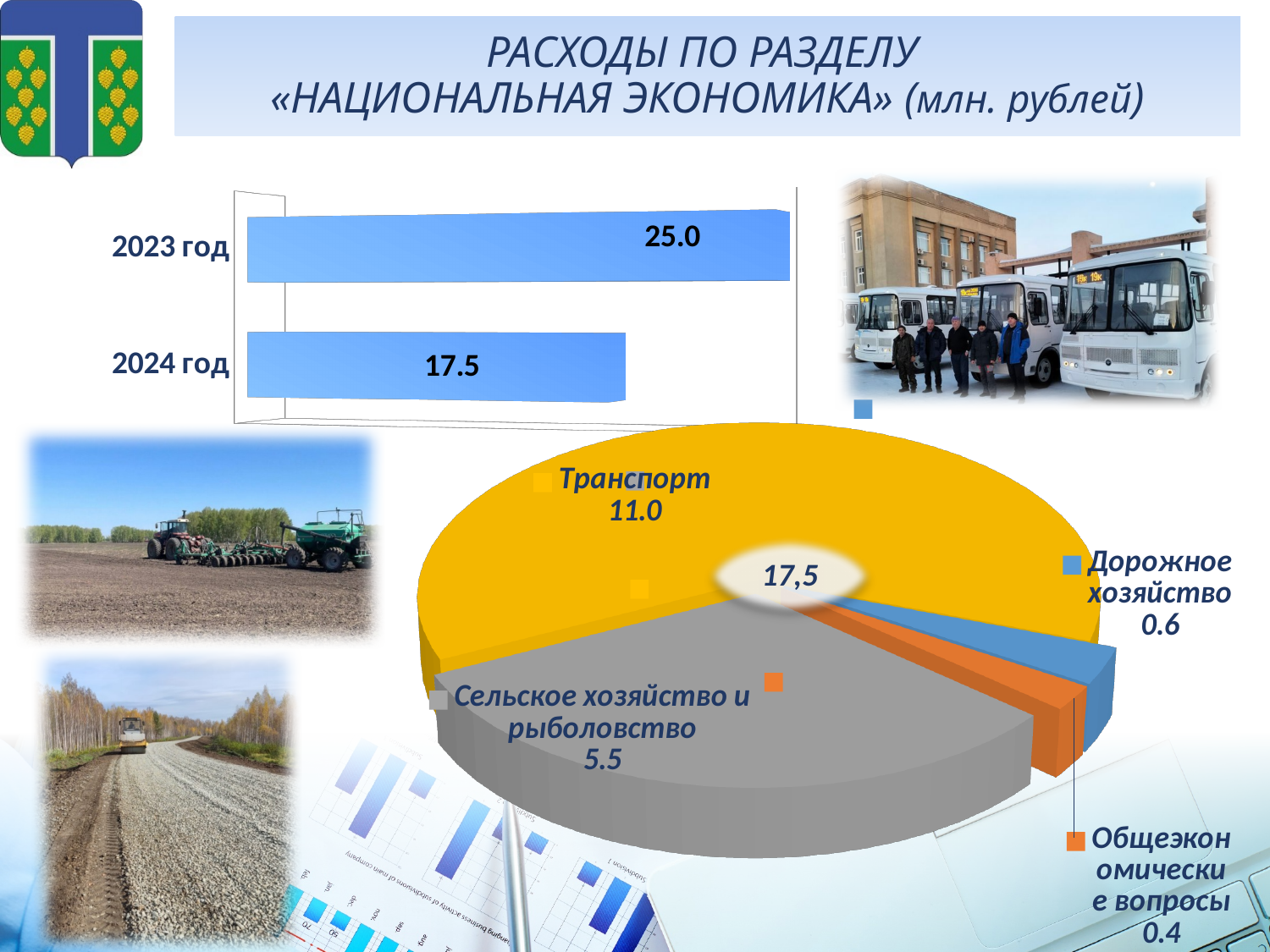
On the bar chart, what is the difference between the 2023 год and 2024 год values? 7.5 On the bar chart, what is the value for 2023 год? 25.0 On the bar chart, what is the value for 2024 год? 17.5 On the pie chart, what is the value for Дорожное хозяйство? 0.6 On the pie chart, how many slices are there? 4 On the pie chart, what is the difference between Транспорт and Сельское хозяйство и рыболовство? 5.5 On the pie chart, what is the value for Сельское хозяйство и рыболовство? 5.5 On the bar chart, which year has the higher value? 2023 год On the pie chart, which category has the smallest value? Общеэкономические вопросы What kind of chart is the one at the top of the slide showing 2023 год and 2024 год? bar chart On the pie chart, what is the value for Транспорт? 11.0 On the bar chart, how many categories are shown? 2